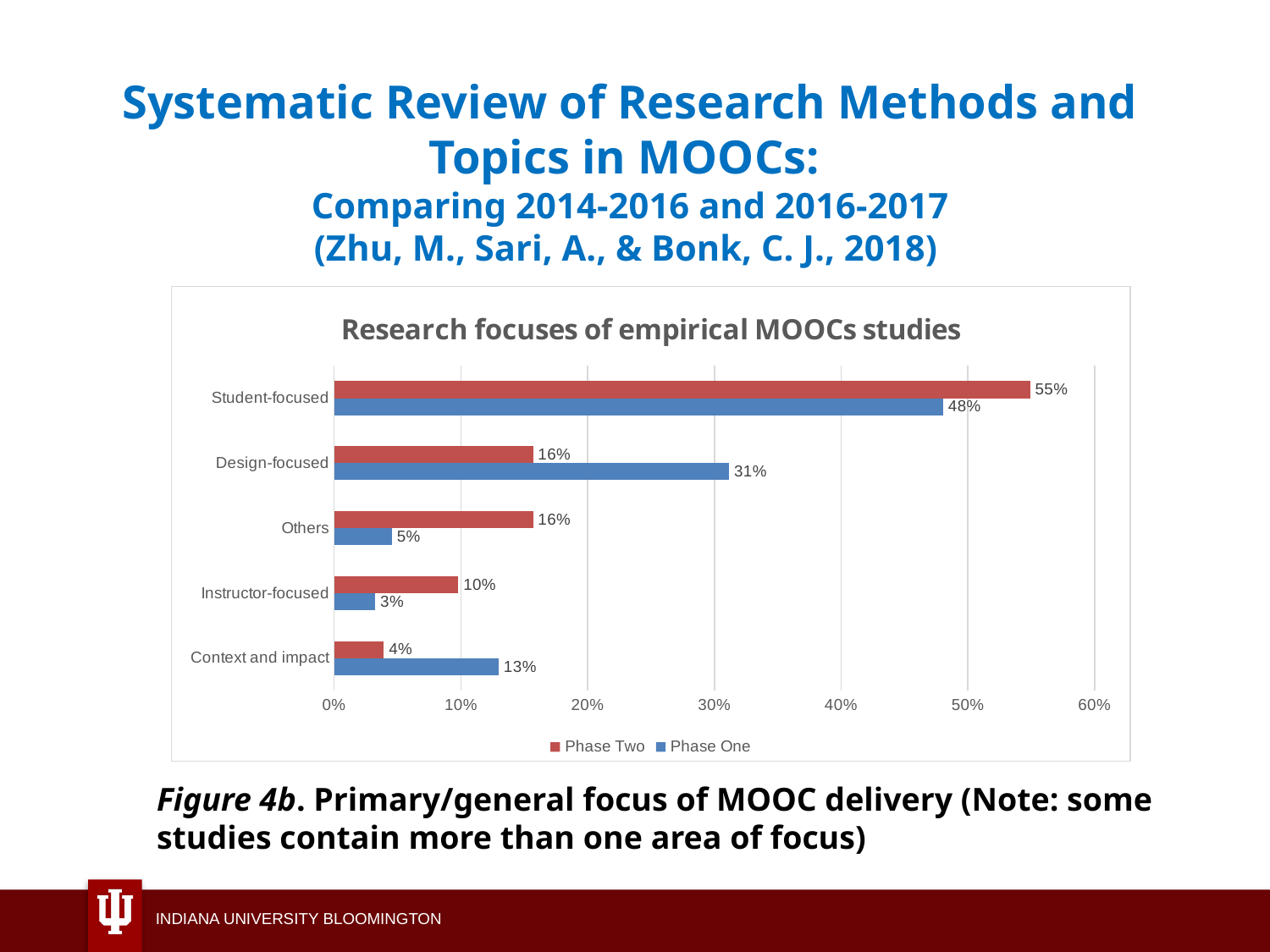
Which category has the highest Phase One value? Student-focused How many categories are shown on the chart? 5 What kind of chart is shown on the slide? Bar chart What is the Phase One value for Context and impact? 13% How many series does the legend list? 2 What is the Phase One value for Design-focused? 31% Which is larger for Others: the Phase One value or the Phase Two value? Phase Two Is the Phase One value for Student-focused greater or less than 40%? greater What is the difference between the Phase Two and Phase One values for Design-focused? 15% Which category has the lowest Phase Two value? Context and impact What is the title of the chart? Research focuses of empirical MOOCs studies What is the Phase Two value for Student-focused? 55%